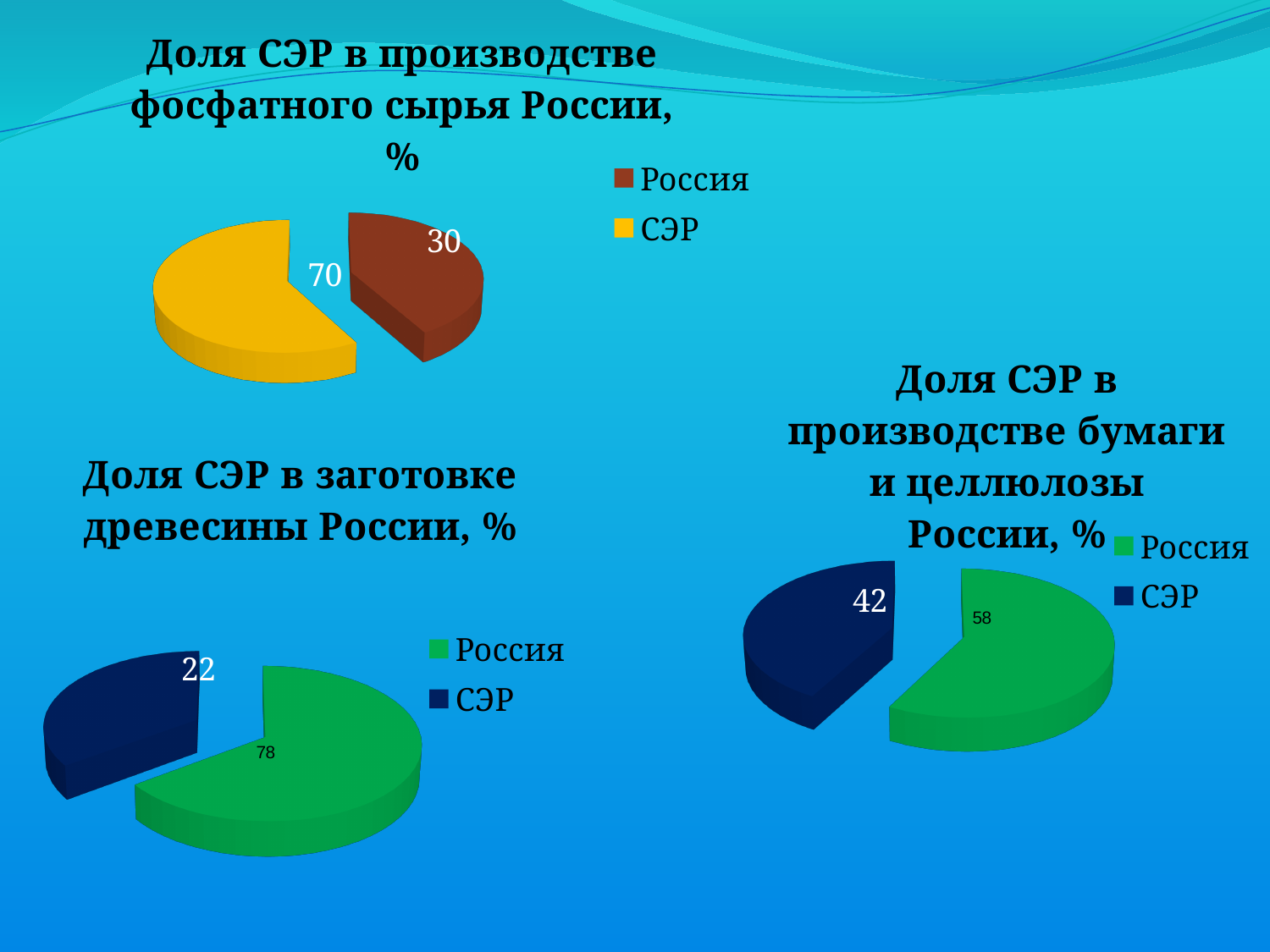
How many entries does the legend of the chart 'Доля СЭР в производстве бумаги и целлюлозы России, %' list? 2 In the chart 'Доля СЭР в производстве фосфатного сырья России, %', what is the value for СЭР? 70 In the chart 'Доля СЭР в заготовке древесины России, %', what is the value for Россия? 78 In the chart 'Доля СЭР в производстве фосфатного сырья России, %', what is the value for Россия? 30 In the chart 'Доля СЭР в производстве бумаги и целлюлозы России, %', what is the value for Россия? 58 In the chart 'Доля СЭР в заготовке древесины России, %', which slice is the smallest? СЭР In the chart 'Доля СЭР в производстве бумаги и целлюлозы России, %', what is the difference between the Россия and СЭР values? 16 In the chart 'Доля СЭР в заготовке древесины России, %', what is the value for СЭР? 22 In the chart 'Доля СЭР в производстве фосфатного сырья России, %', which slice is the largest? СЭР In the chart 'Доля СЭР в заготовке древесины России, %', which is larger, Россия or СЭР? Россия In the chart 'Доля СЭР в производстве бумаги и целлюлозы России, %', what is the value for СЭР? 42 What kind of chart is 'Доля СЭР в производстве фосфатного сырья России, %'? Pie chart